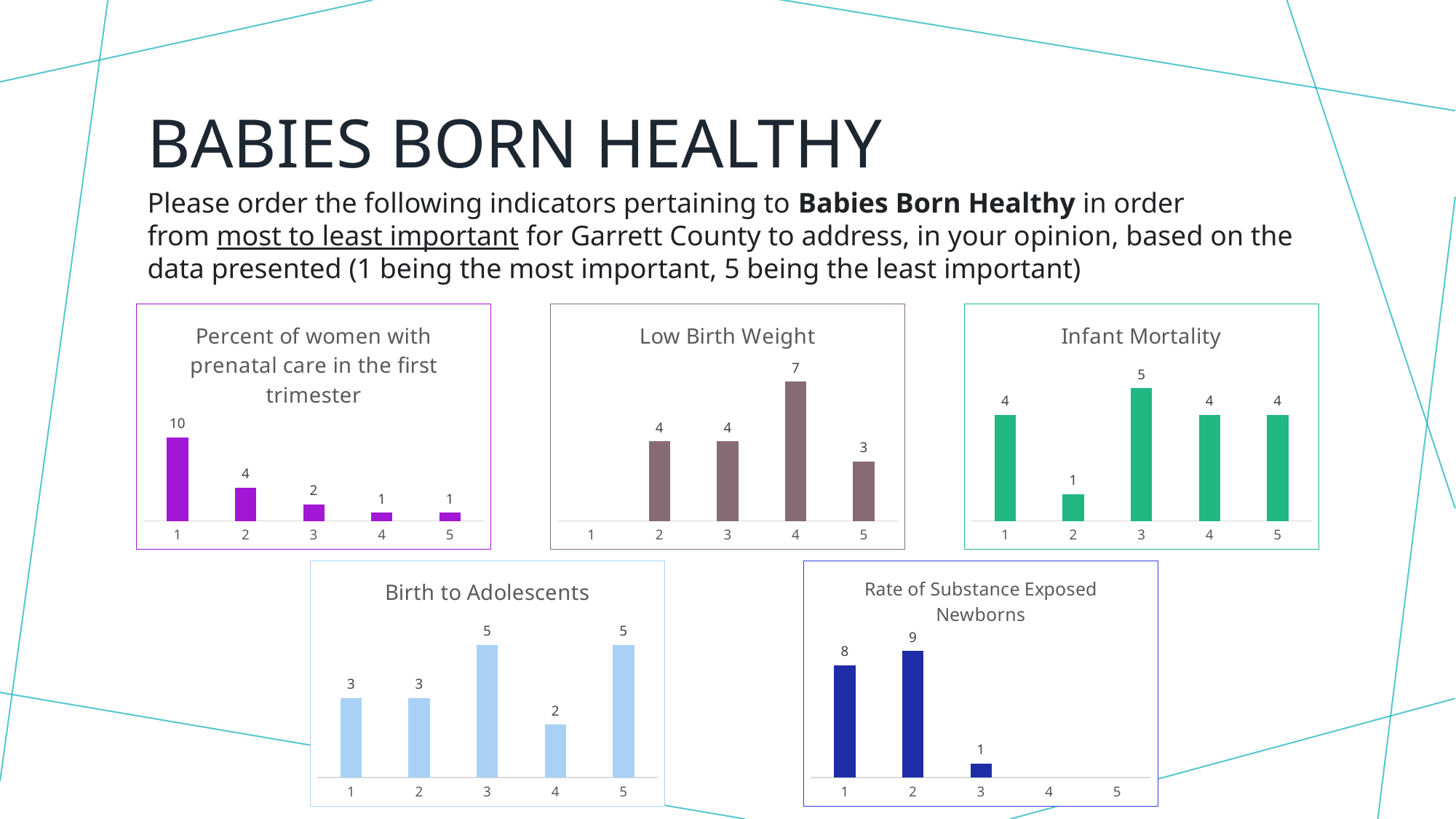
In the 'Low Birth Weight' chart, what is the value for rank 5? 3 In the 'Percent of women with prenatal care in the first trimester' chart, what is the total of all five values? 18 In the 'Percent of women with prenatal care in the first trimester' chart, what is the value for rank 1? 10 In the 'Rate of Substance Exposed Newborns' chart, what is the value for rank 3? 1 In the 'Percent of women with prenatal care in the first trimester' chart, do the values rise or fall from rank 1 to rank 5? fall What kind of chart is the 'Birth to Adolescents' chart? bar chart In the 'Low Birth Weight' chart, which rank has the highest value? 4 In the 'Infant Mortality' chart, what is the value for rank 3? 5 In the 'Rate of Substance Exposed Newborns' chart, which is larger, the value for rank 1 or rank 2? rank 2 How many charts are shown on the slide? 5 In the 'Birth to Adolescents' chart, what is the difference between the values for rank 3 and rank 4? 3 In the 'Infant Mortality' chart, which rank has the lowest value? 2